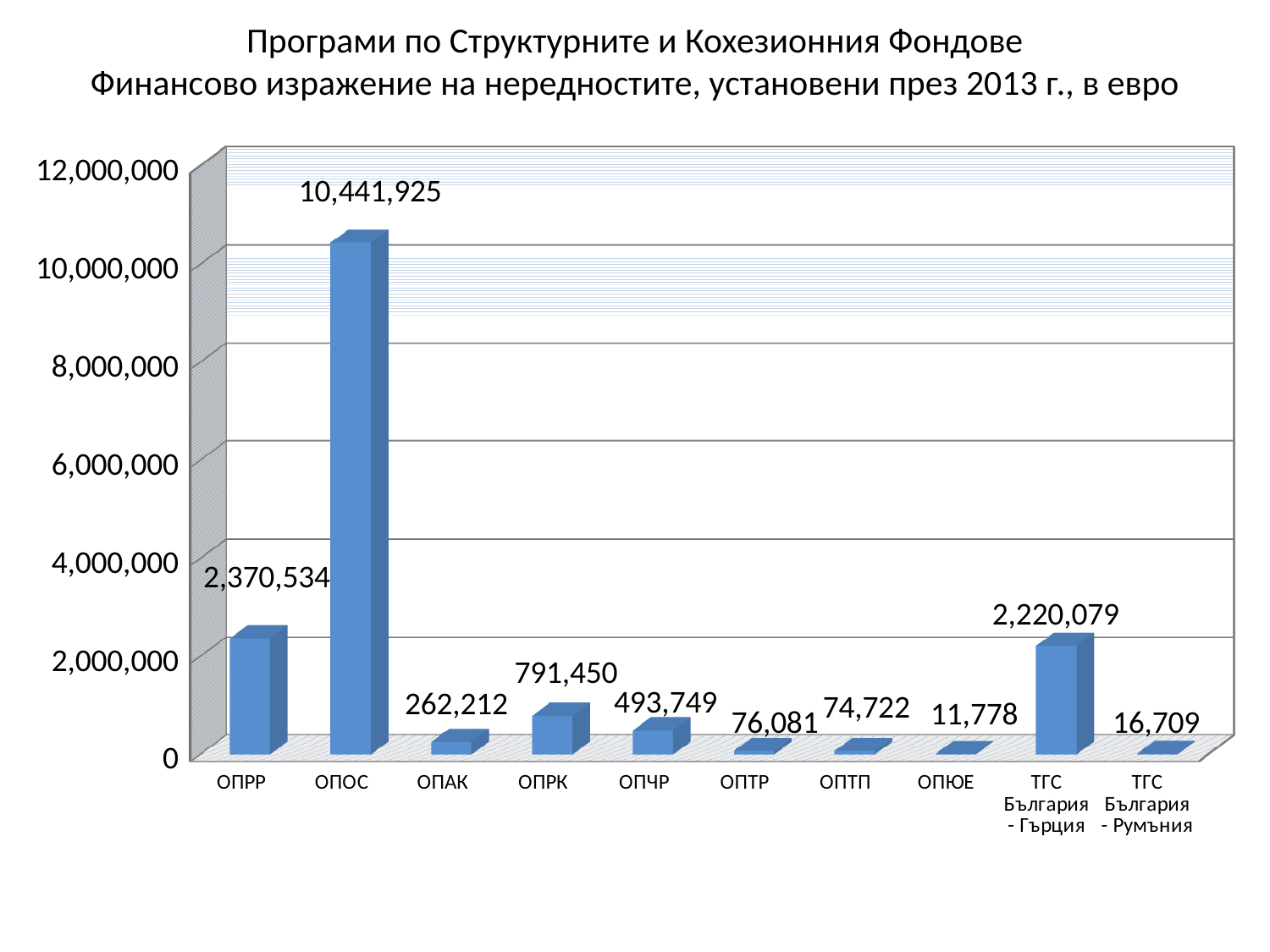
What is the value for ОПОС? 10,441,925 What is the value for ОПЮЕ? 11,778 Which category has the lowest value? ОПЮЕ What kind of chart is shown on the slide? bar chart How many categories are shown on the x axis? 10 Which category has the highest value? ОПОС Is the value for ОПОС greater or less than 10,000,000? greater Which is larger, the value for ОПАК or the value for ОПРК? ОПРК What is the difference between the values for ОПРР and ТГС България - Гърция? 150,455 What is the value for ТГС България - Гърция? 2,220,079 What is the value for ОПЧР? 493,749 What is the difference between the values for ОПРК and ОПЧР? 297,701